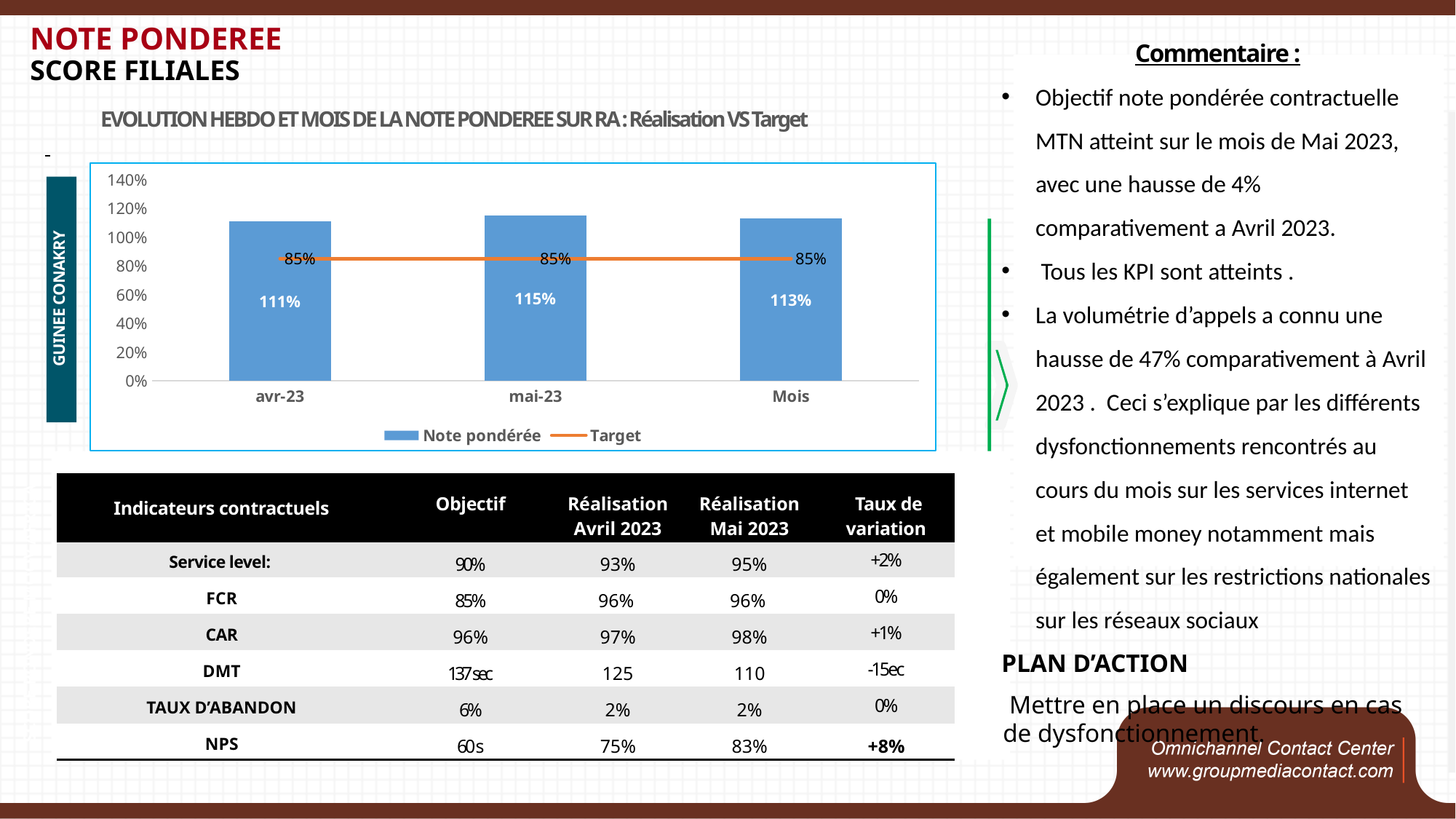
What is the difference between the Note pondérée and the Target for the Mois category? 28% What is the difference between the Note pondérée values for mai-23 and avr-23? 4% How many categories are shown on the x axis of the chart? 3 What type of chart is used to show the Note pondérée values? Bar chart How many series does the chart legend list? 2 What is the Note pondérée value for the Mois category? 113% What is the Note pondérée value for mai-23? 115% Is the Note pondérée for avr-23 greater or less than 100%? greater What is the Target value for mai-23? 85% Which category has the lowest Note pondérée value? avr-23 What is the Note pondérée value for avr-23? 111% Which category has the highest Note pondérée value? mai-23